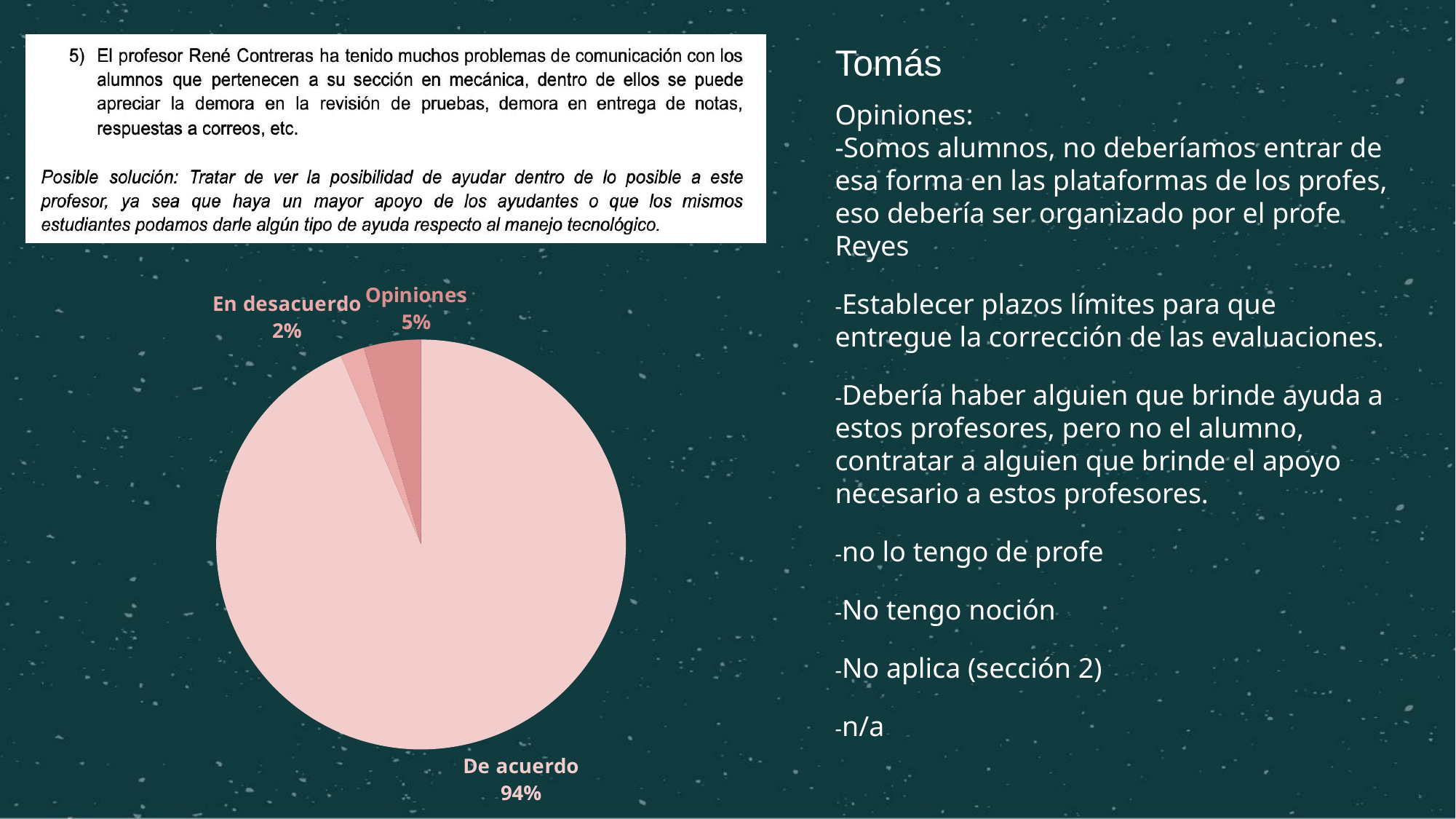
What is the difference in percentage points between the "Opiniones" slice and the "En desacuerdo" slice? 3 Which slice of the pie chart is drawn in the darkest shade of pink? Opiniones What percentage of the pie chart is labelled "De acuerdo"? 94% Which slice of the pie chart is the smallest? En desacuerdo What is the difference in percentage points between the "De acuerdo" slice and the "Opiniones" slice? 89 How many slices does the pie chart have? 3 What percentage of the pie chart is labelled "En desacuerdo"? 2% What percentage of the pie chart is labelled "Opiniones"? 5% What kind of chart is shown on the slide? pie chart Which is larger in the pie chart, "Opiniones" or "En desacuerdo"? Opiniones Which slice of the pie chart is the largest? De acuerdo Is the "De acuerdo" slice greater or less than half of the pie chart? greater